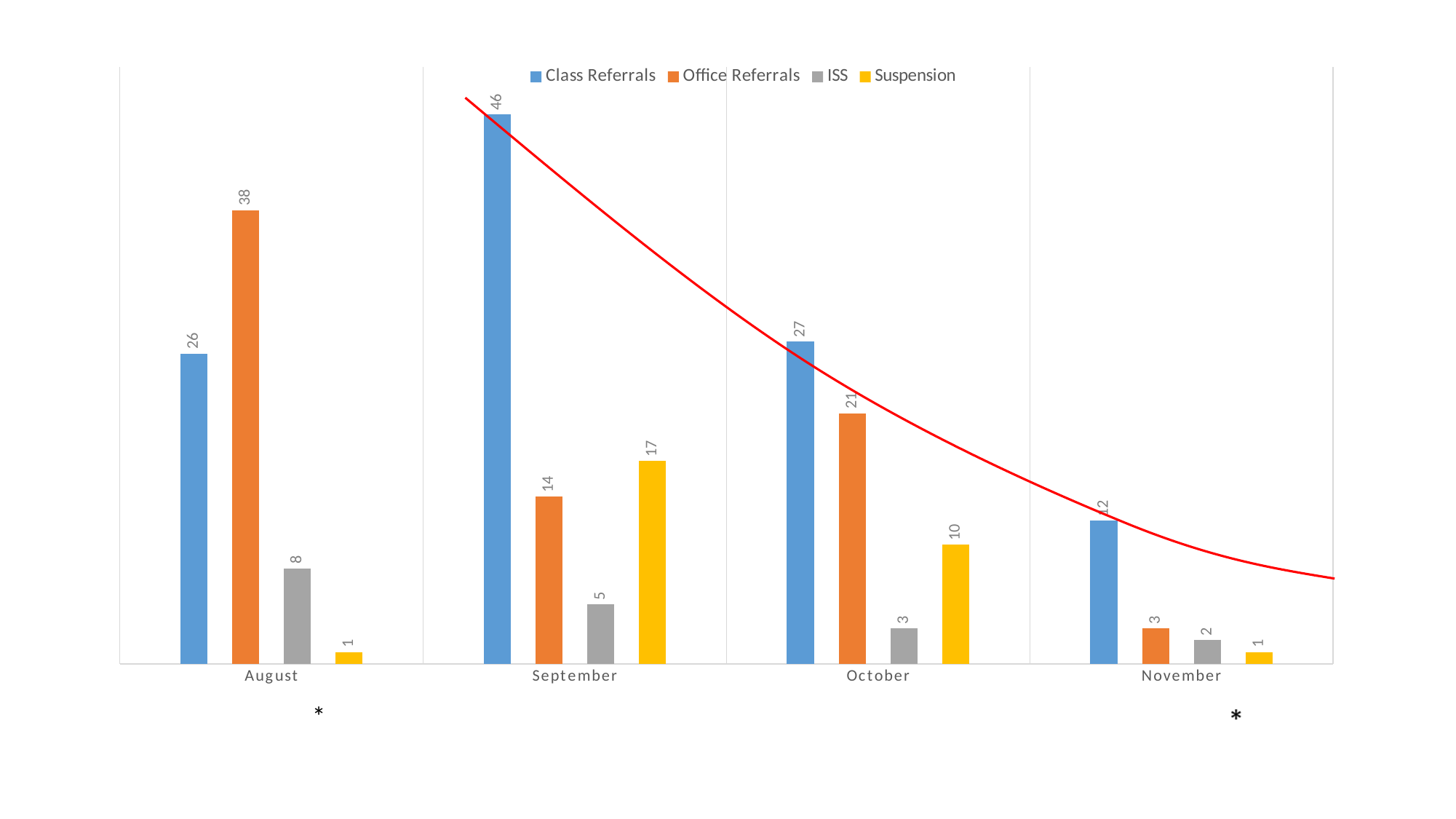
In which month is the Class Referrals value highest? September What is the value for Class Referrals in September? 46 How many months are shown on the x axis? 4 In which month is the Office Referrals value lowest? November Which is larger in August: Class Referrals or Office Referrals? Office Referrals What is the difference between Class Referrals and Office Referrals in October? 6 What is the value for Suspension in October? 10 What kind of chart is shown on the slide? Bar chart Do the ISS values rise or fall from September to November? Fall What is the value for ISS in November? 2 What is the value for Office Referrals in August? 38 How many series does the legend list? 4